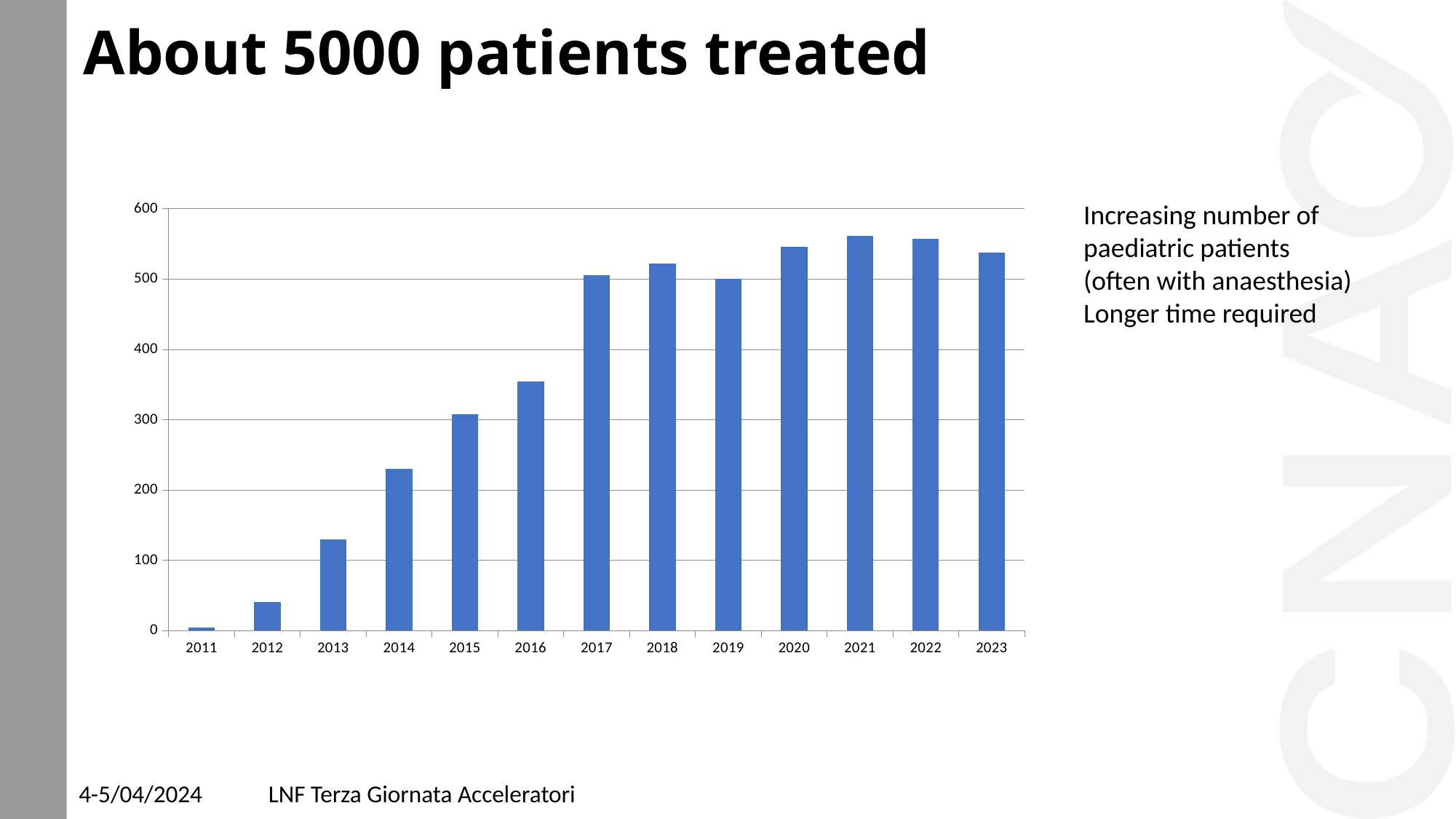
What is the title of the slide containing the chart? About 5000 patients treated Is the value for 2016 greater or less than 300? greater Which year has the lowest bar in the chart? 2011 Which year has the larger value, 2016 or 2017? 2017 What colour are the bars in the chart? blue Is the value for 2013 greater or less than 200? less What kind of chart is shown on the slide? bar chart Is the value for 2021 greater or less than 500? greater How many years are shown on the x axis of the chart? 13 Which year has the larger value, 2019 or 2020? 2020 Do the values generally rise or fall from 2011 to 2021? rise